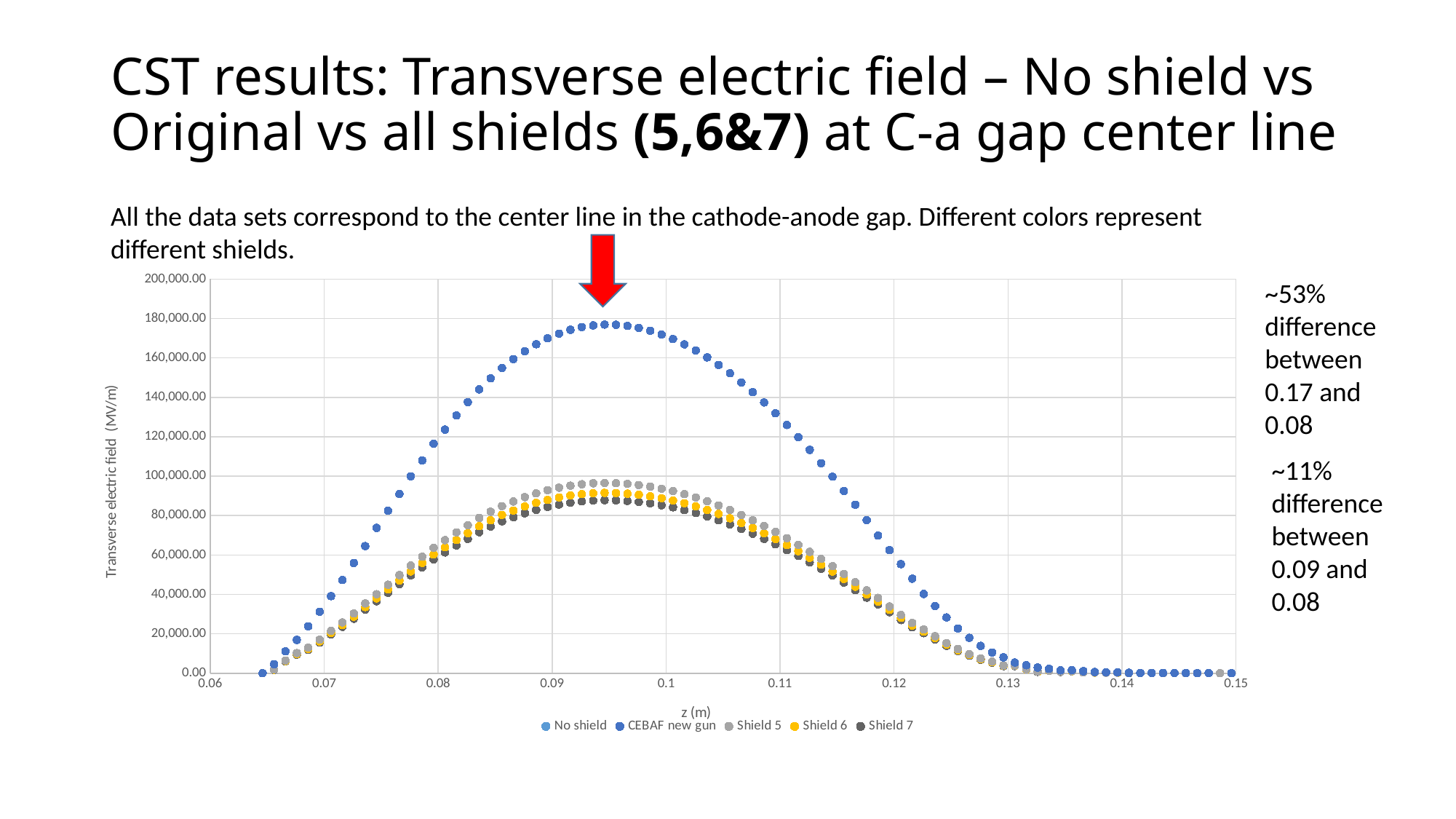
Among Shield 5, Shield 6 and Shield 7, which series has the lowest peak? Shield 7 Is the value of the highest curve at z = 0.08 greater or less than 100,000.00? greater What kind of chart is shown on the slide? Scatter chart At z = 0.1, which is larger: the value of the highest curve or the value of Shield 5? The highest curve Among Shield 5, Shield 6 and Shield 7, which series has the highest peak? Shield 5 What is the label of the x axis? z (m) What is the label of the y axis? Transverse electric field (MV/m) Do the values of the series rise or fall along the x axis between z = 0.1 and z = 0.13? fall How many series does the legend list? 5 Is the peak value of the highest curve greater or less than 160,000.00? greater Is the peak value of the Shield 5 series greater or less than 100,000.00? less